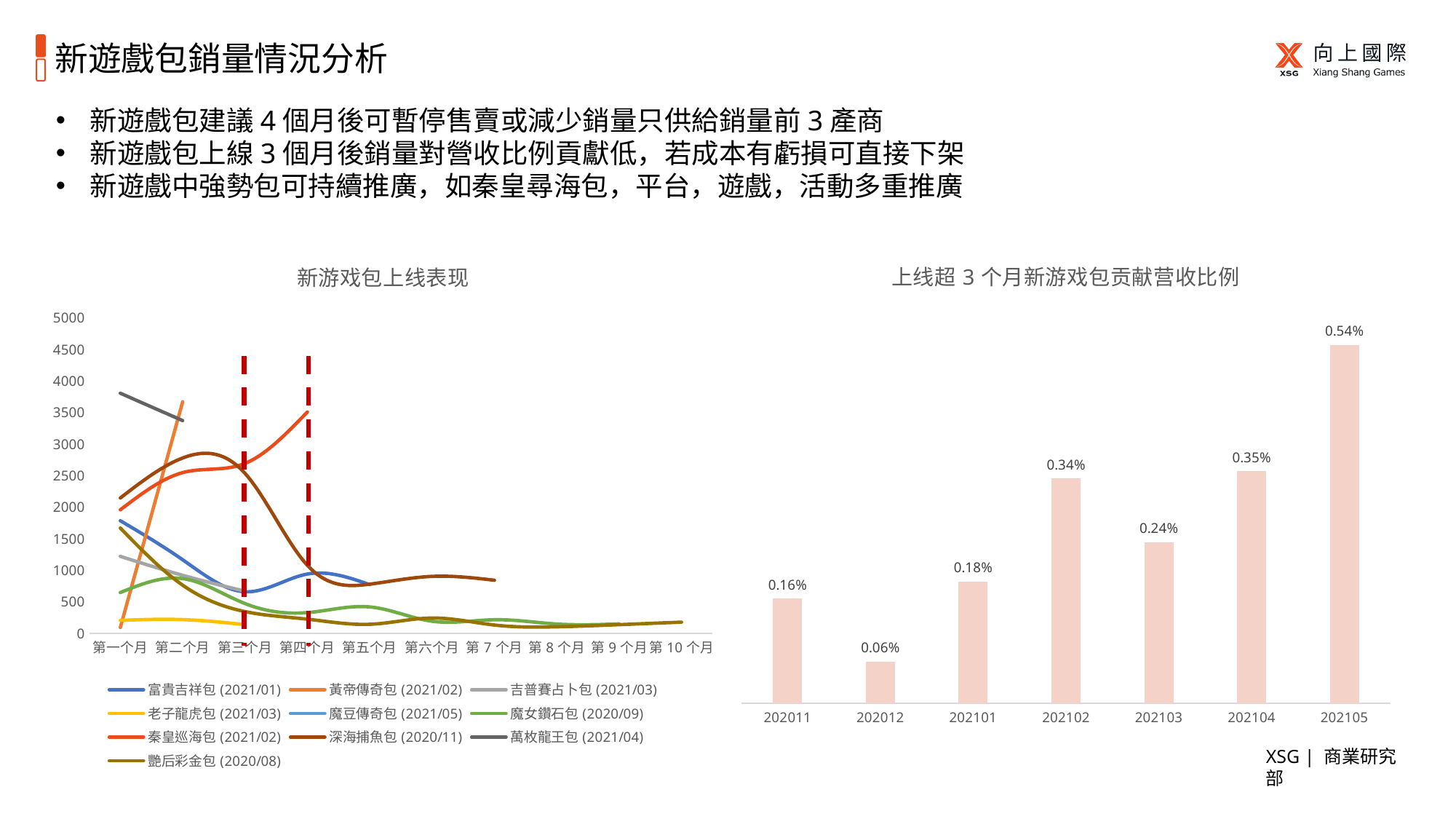
In the chart titled 上线超 3 个月新游戏包贡献营收比例, what is the value for 202102? 0.34% In the chart titled 上线超 3 个月新游戏包贡献营收比例, what is the value for 202012? 0.06% In the chart titled 新游戏包上线表现, is the value for 萬枚龍王包 (2021/04) in 第一个月 greater or less than 3500? greater What kind of chart is the chart titled 上线超 3 个月新游戏包贡献营收比例? bar chart In the chart titled 上线超 3 个月新游戏包贡献营收比例, what is the difference between the values for 202105 and 202104? 0.19% In the chart titled 上线超 3 个月新游戏包贡献营收比例, what is the value for 202105? 0.54% In the chart titled 上线超 3 个月新游戏包贡献营收比例, which category has the highest value? 202105 How many series does the legend of the chart titled 新游戏包上线表现 list? 10 How many bars are in the chart titled 上线超 3 个月新游戏包贡献营收比例? 7 In the chart titled 上线超 3 个月新游戏包贡献营收比例, which is larger, the value for 202103 or the value for 202101? 202103 What kind of chart is the chart titled 新游戏包上线表现? line chart In the chart titled 上线超 3 个月新游戏包贡献营收比例, which category has the lowest value? 202012